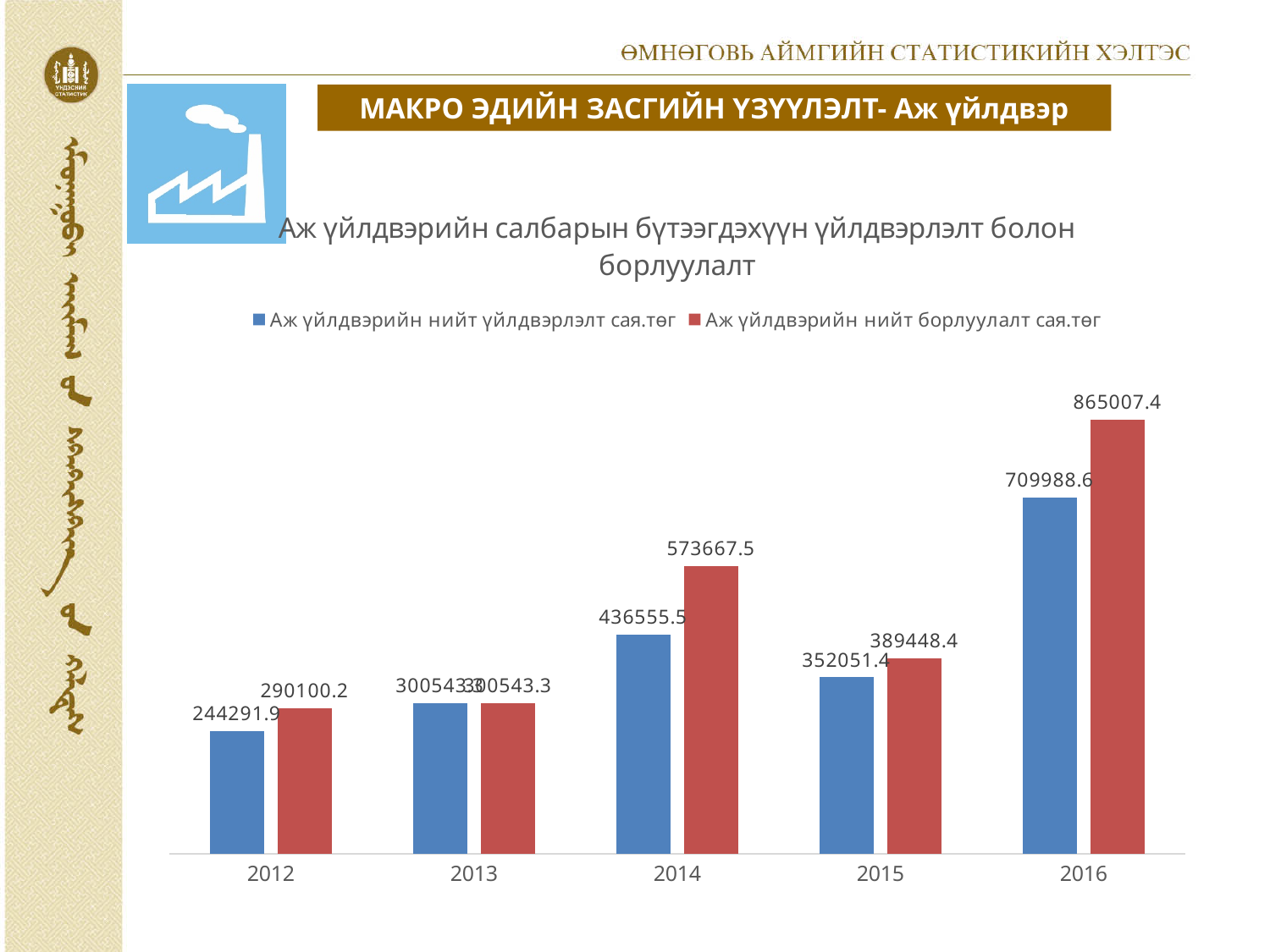
What is the value of Аж үйлдвэрийн нийт үйлдвэрлэлт сая.төг for 2012? 244291.9 How many series does the chart legend list? 2 What is the difference between Аж үйлдвэрийн нийт борлуулалт сая.төг and Аж үйлдвэрийн нийт үйлдвэрлэлт сая.төг in 2016? 155018.8 How many years are shown on the x axis of the chart? 5 In which year is Аж үйлдвэрийн нийт борлуулалт сая.төг highest? 2016 What type of chart is shown on the slide? bar chart Which is larger in 2014: Аж үйлдвэрийн нийт үйлдвэрлэлт сая.төг or Аж үйлдвэрийн нийт борлуулалт сая.төг? Аж үйлдвэрийн нийт борлуулалт сая.төг What is the value of Аж үйлдвэрийн нийт борлуулалт сая.төг for 2014? 573667.5 What is the value of Аж үйлдвэрийн нийт үйлдвэрлэлт сая.төг for 2016? 709988.6 Did Аж үйлдвэрийн нийт үйлдвэрлэлт сая.төг rise or fall from 2014 to 2015? fall In which year is Аж үйлдвэрийн нийт үйлдвэрлэлт сая.төг lowest? 2012 What is the value of Аж үйлдвэрийн нийт борлуулалт сая.төг for 2015? 389448.4